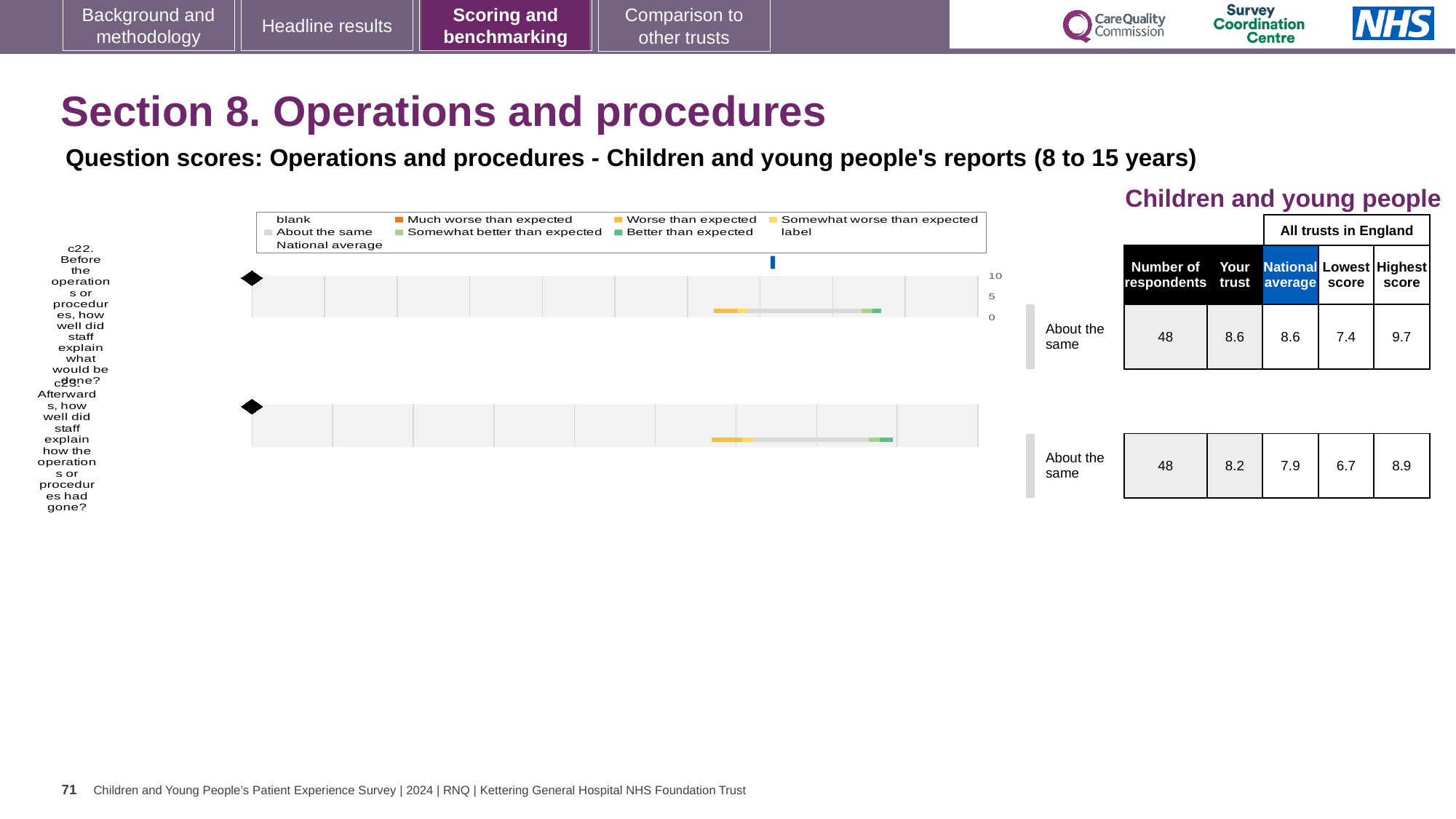
What is the lowest score among all trusts in England for c23? 6.7 What benchmark category is shown for both c22 and c23? About the same Which question has the higher 'Your trust' score, c22 or c23? c22 What kind of chart is used to show the question scores for c22 and c23? bar chart How many respondents answered question c22? 48 What is the difference between the 'Your trust' score and the national average for c23? 0.3 What is the difference between the highest and lowest scores in England for c22? 2.3 What is the 'Your trust' score for c22 (Before the operations or procedures, how well did staff explain what would be done?)? 8.6 What is the national average score for c23 (Afterwards, how well did staff explain how the operations or procedures had gone?)? 7.9 How many survey questions (bars) are plotted on the slide? 2 What is the highest score among all trusts in England for c22? 9.7